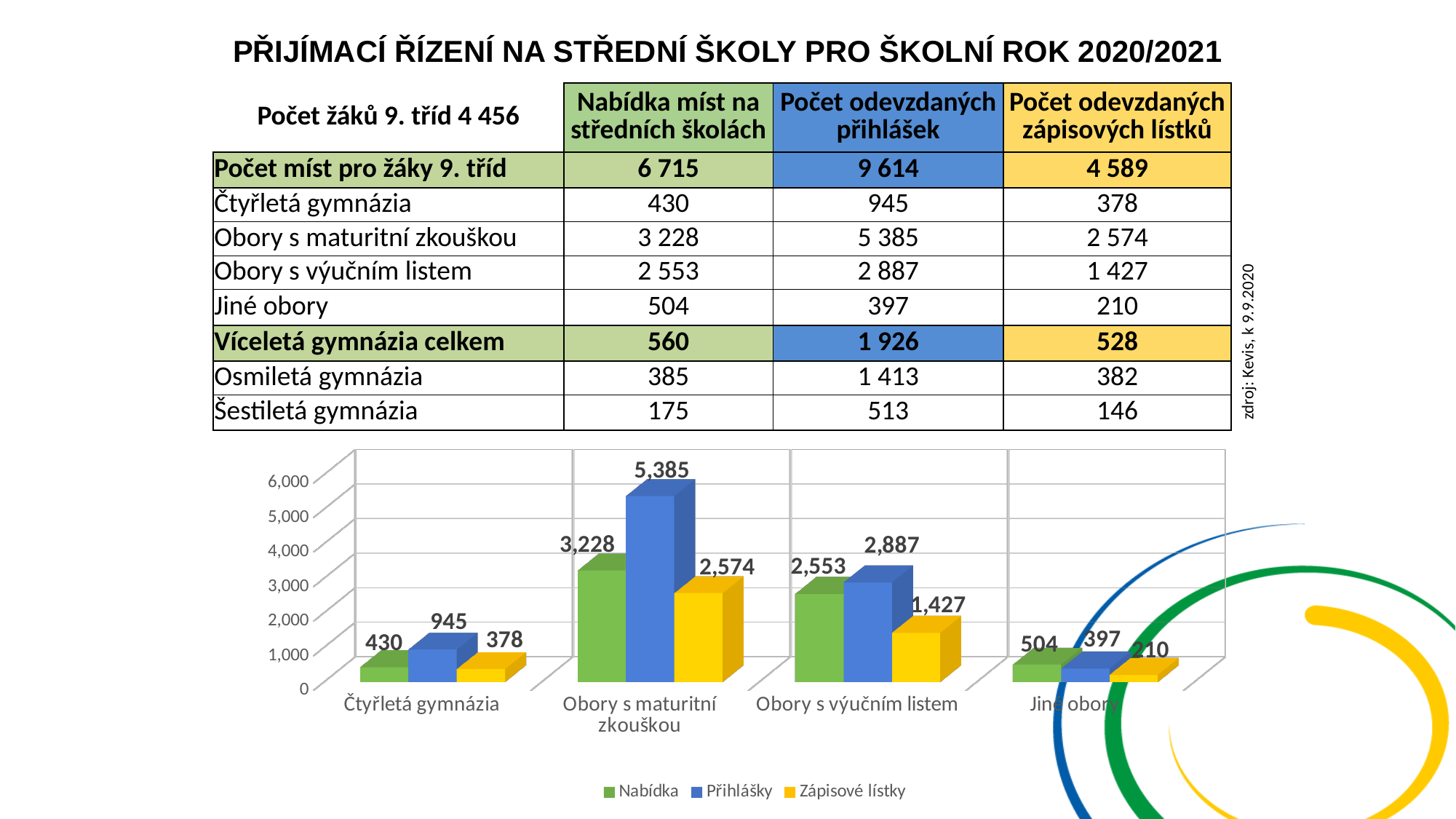
Which category has the highest Přihlášky value in the chart? Obory s maturitní zkouškou Is the Přihlášky value for Obory s výučním listem greater or less than 2,000 in the chart? greater Which category has the lowest Zápisové lístky value in the chart? Jiné obory What is the value of Přihlášky for Obory s maturitní zkouškou in the chart? 5,385 Which colour represents the Zápisové lístky series in the chart? yellow How many categories are shown on the x axis of the chart? 4 In the chart, is the Nabídka value larger for Jiné obory or for Čtyřletá gymnázia? Jiné obory What type of chart is shown on the slide? bar chart What is the difference between Přihlášky and Nabídka for Obory s maturitní zkouškou in the chart? 2,157 How many series does the chart legend list? 3 What is the value of Zápisové lístky for Čtyřletá gymnázia in the chart? 378 What is the value of Nabídka for Obory s výučním listem in the chart? 2,553